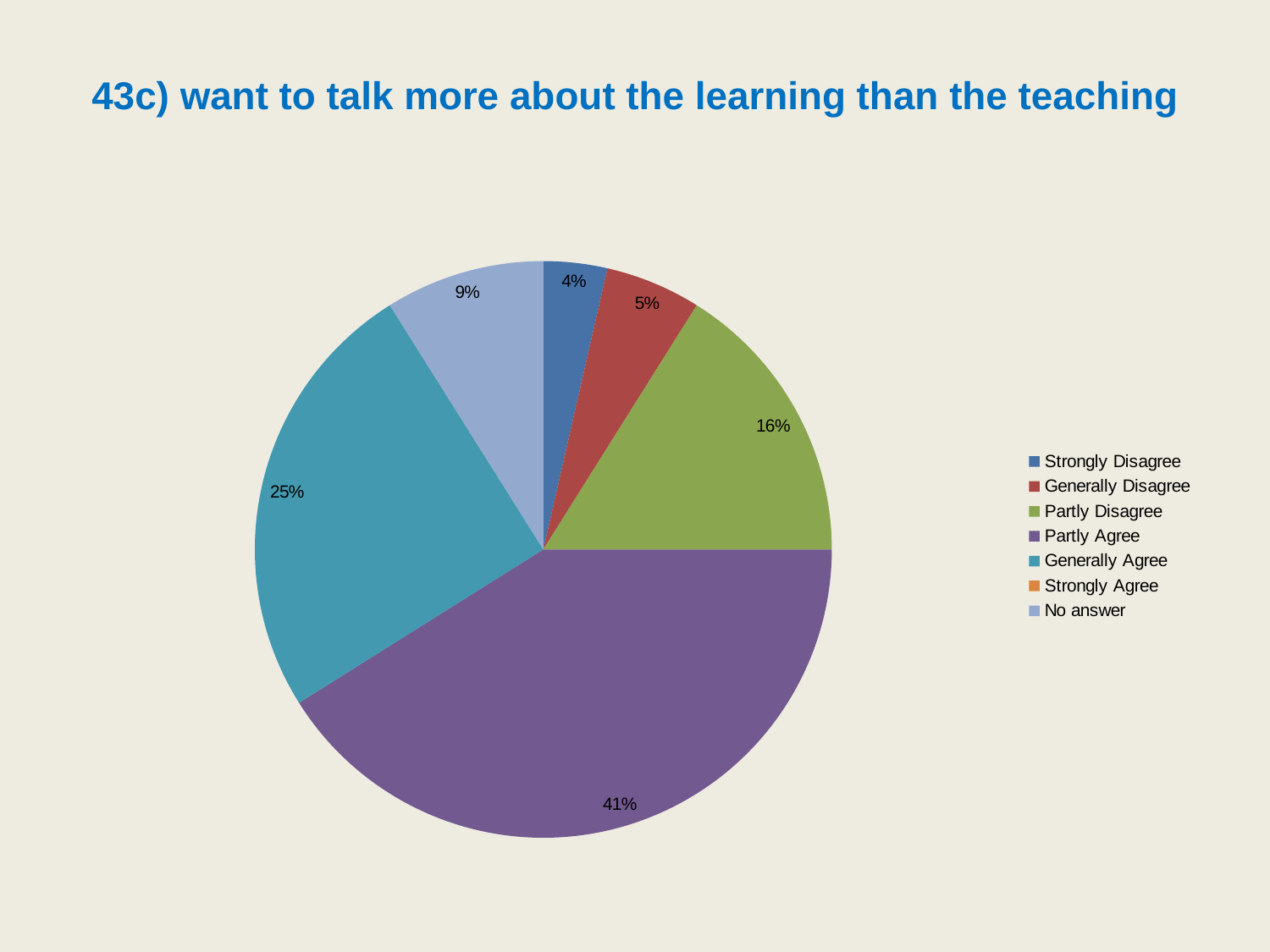
What is the difference in percentage points between Partly Agree and Generally Agree? 16 Which is larger, the share for Partly Disagree or the share for No answer? Partly Disagree Which response category has the largest share of the pie? Partly Agree What percentage of respondents chose Generally Agree? 25% What percentage of respondents gave No answer? 9% What kind of chart is shown on the slide? Pie chart What percentage of respondents chose Strongly Disagree? 4% Which of the labelled slices has the smallest share? Strongly Disagree What percentage of respondents chose Partly Disagree? 16% How many entries does the legend list? 7 What percentage of respondents chose Partly Agree? 41% What is the title of the chart? 43c) want to talk more about the learning than the teaching